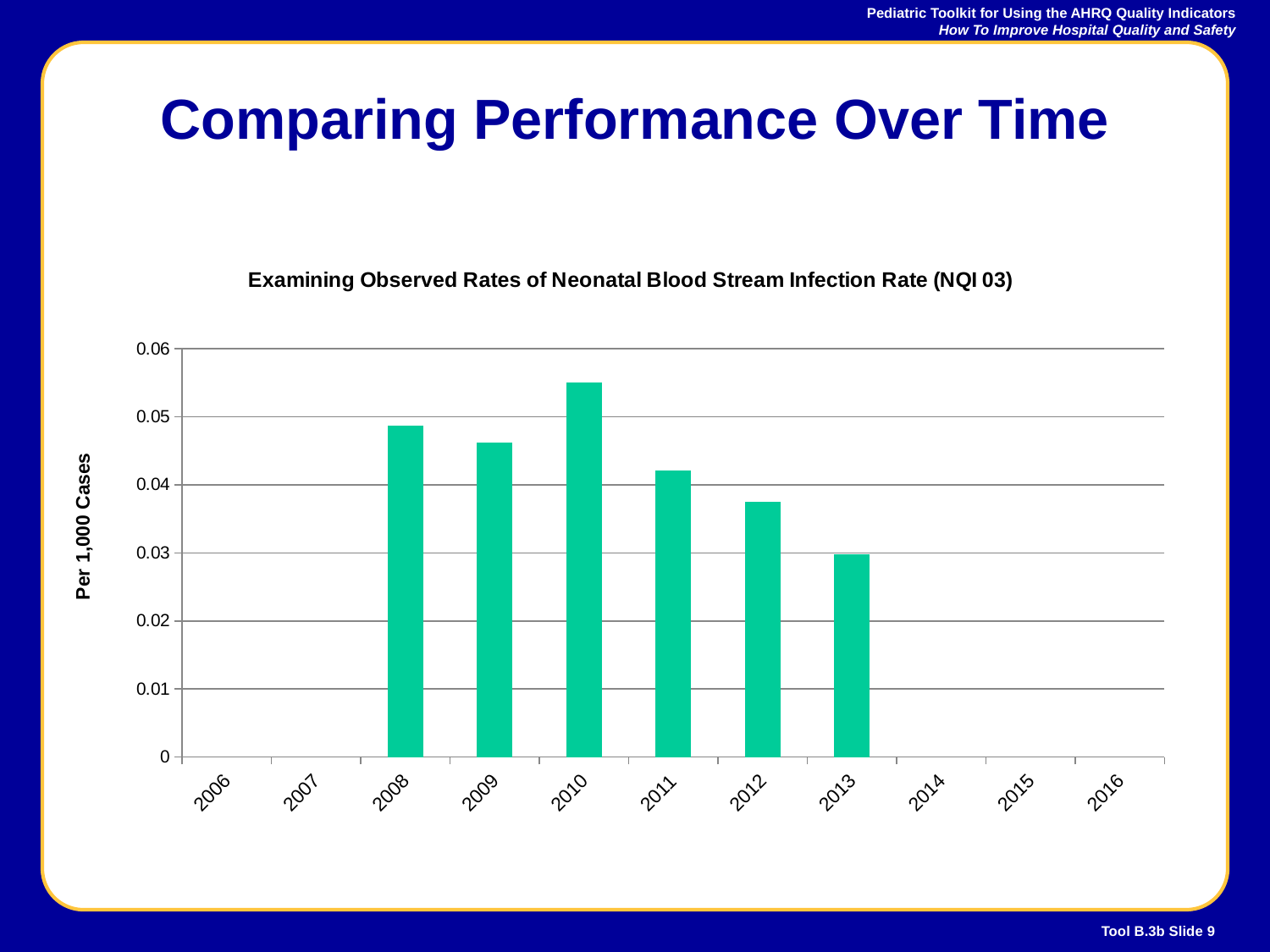
Do the values rise or fall from 2010 to 2013? fall What is the label on the vertical axis of the chart? Per 1,000 Cases Which year has the highest observed rate? 2010 What kind of chart is shown on the slide? bar chart Is the value for 2012 greater or less than 0.04? less Is the value for 2009 greater or less than 0.04? greater How many year labels are shown along the x axis? 11 How many years have a bar plotted on the chart? 6 Which year has the larger value, 2011 or 2012? 2011 What is the title of the chart? Examining Observed Rates of Neonatal Blood Stream Infection Rate (NQI 03) Among the years with a bar shown, which year has the lowest observed rate? 2013 Is the value for 2010 greater or less than 0.05? greater